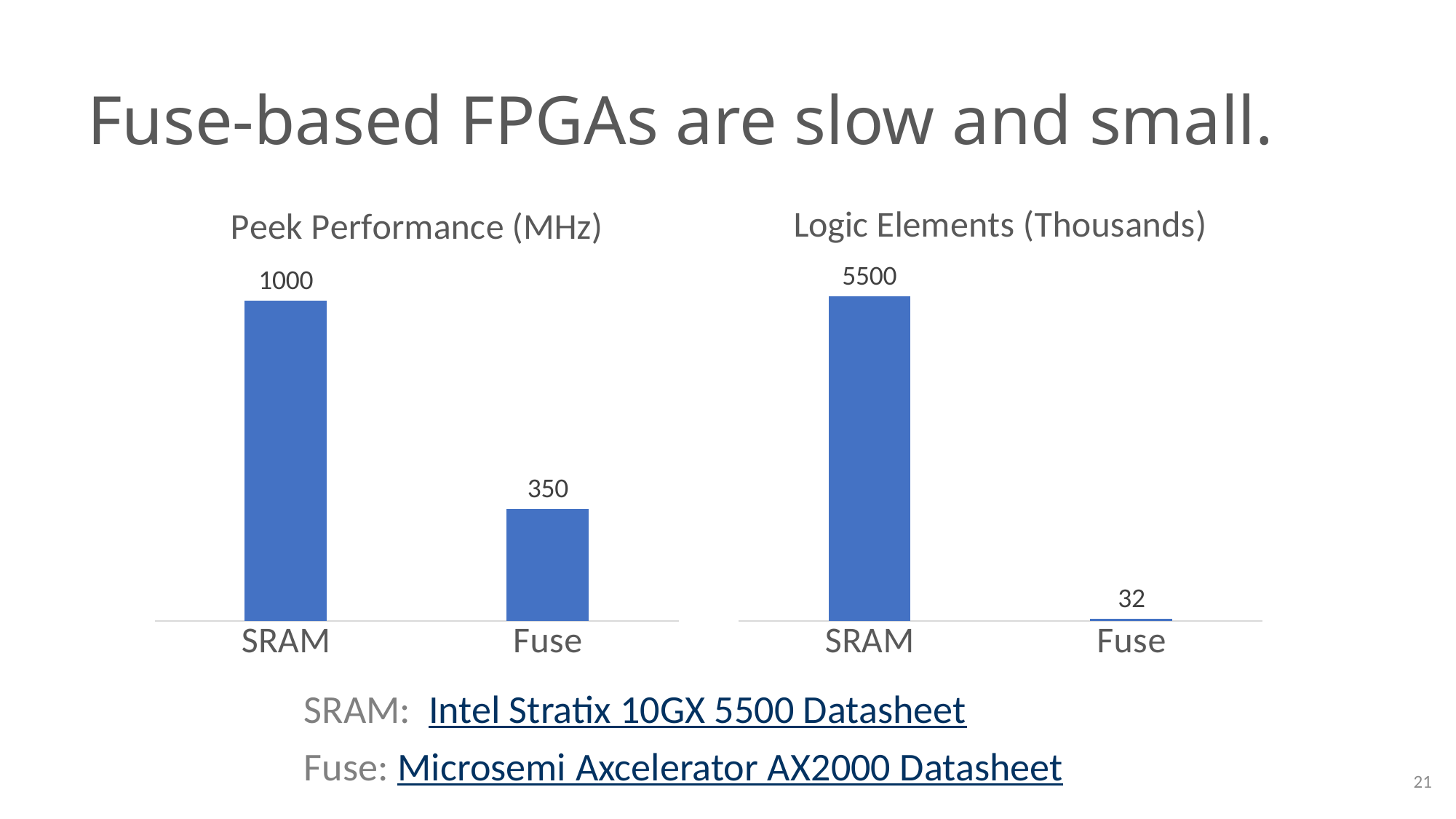
What kind of chart is the Logic Elements (Thousands) chart? Bar chart In the Peek Performance (MHz) chart, what is the value for SRAM? 1000 In the Logic Elements (Thousands) chart, what is the value for Fuse? 32 In the Logic Elements (Thousands) chart, what is the difference between the SRAM and Fuse values? 5468 In the Logic Elements (Thousands) chart, which is larger, the value for SRAM or the value for Fuse? SRAM What is the title of the chart on the left side of the slide? Peek Performance (MHz) In the Logic Elements (Thousands) chart, which category has the lowest value? Fuse In the Peek Performance (MHz) chart, which category has the highest value? SRAM In the Logic Elements (Thousands) chart, what is the value for SRAM? 5500 How many categories are shown in the Peek Performance (MHz) chart? 2 In the Peek Performance (MHz) chart, what is the difference between the SRAM and Fuse values? 650 In the Peek Performance (MHz) chart, what is the value for Fuse? 350